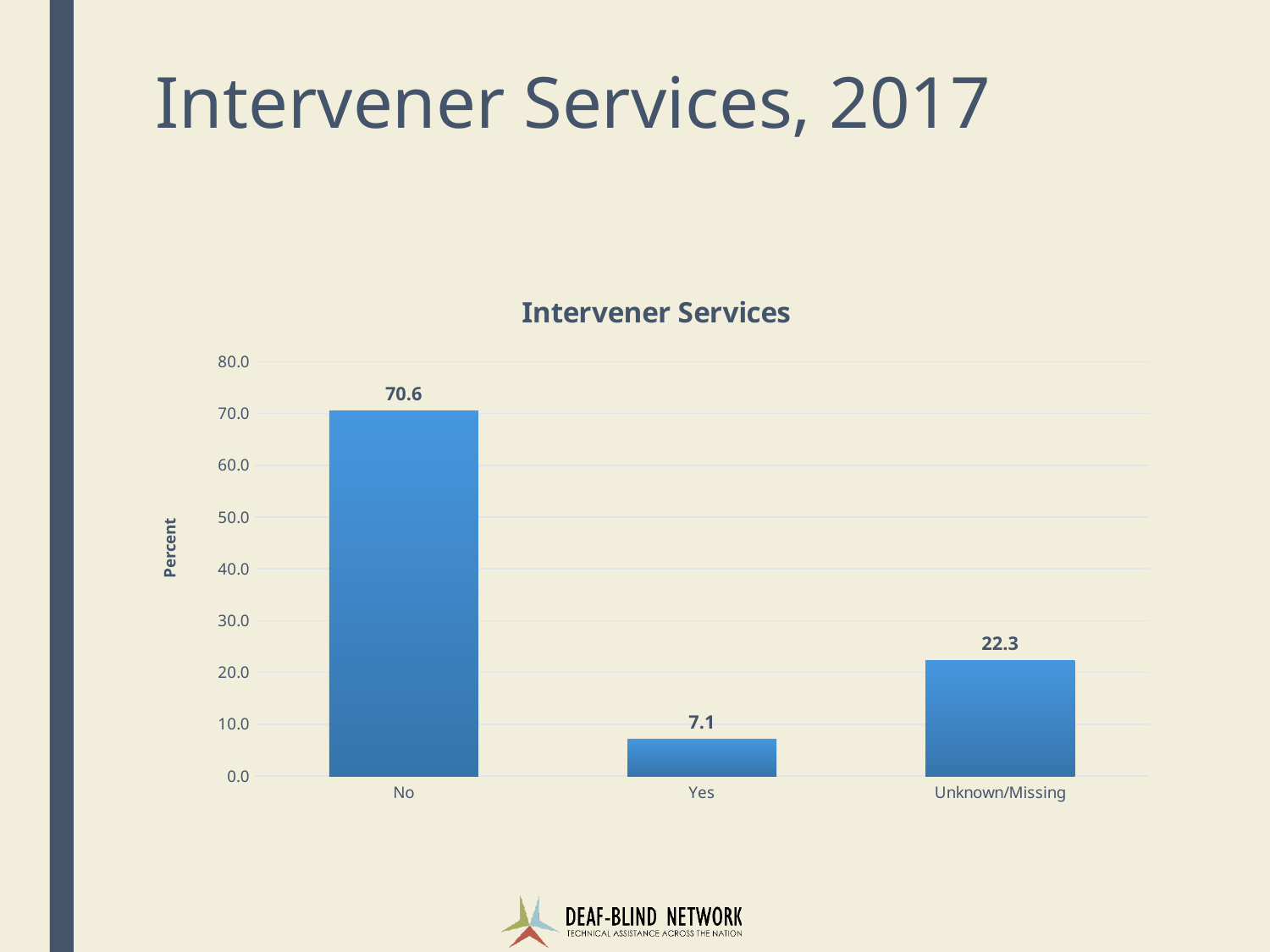
What is the value for No? 70.6 What is the title of the chart? Intervener Services Which is larger, the value for Yes or the value for Unknown/Missing? Unknown/Missing Which category has the lowest value? Yes What is the difference between the values for No and Unknown/Missing? 48.3 Which category has the highest value? No Is the value for No greater or less than 60.0? greater What is the difference between the values for Unknown/Missing and Yes? 15.2 What kind of chart is shown on the slide? bar chart How many categories are shown on the x axis? 3 What is the value for Yes? 7.1 What is the value for Unknown/Missing? 22.3